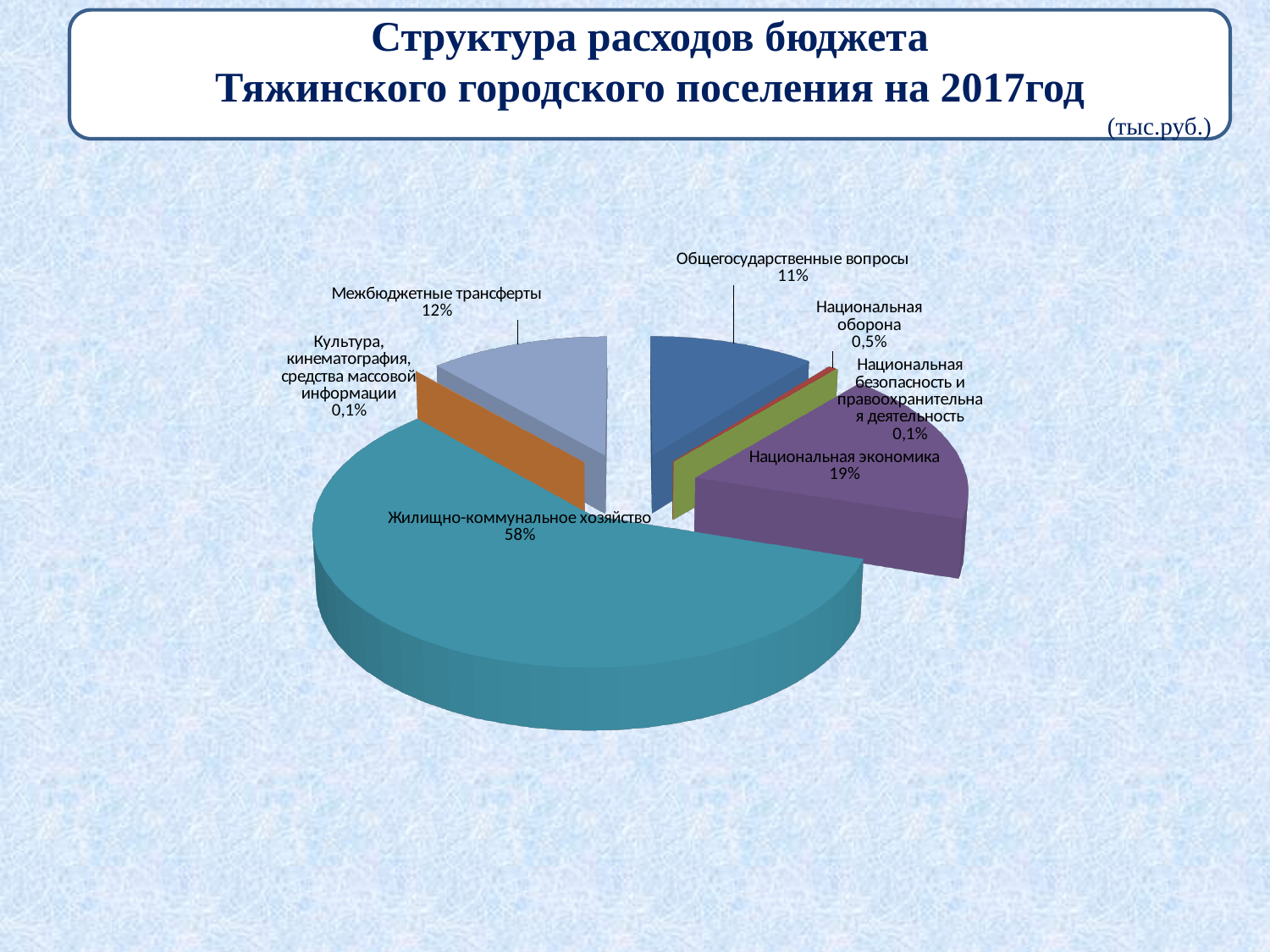
What is the difference in percentage points between the share for Жилищно-коммунальное хозяйство and the share for Национальная экономика? 39 What is the title of the chart on the slide? Структура расходов бюджета Тяжинского городского поселения на 2017год Which is larger: the share for Межбюджетные трансферты or the share for Общегосударственные вопросы? Межбюджетные трансферты What kind of chart is shown on the slide? pie chart What share of the budget expenditure goes to Общегосударственные вопросы? 11% What share of the budget expenditure goes to Жилищно-коммунальное хозяйство? 58% What share of the budget expenditure goes to Культура, кинематография, средства массовой информации? 0,1% How many slices does the pie chart have? 7 Which category has the largest share of the budget expenditure? Жилищно-коммунальное хозяйство